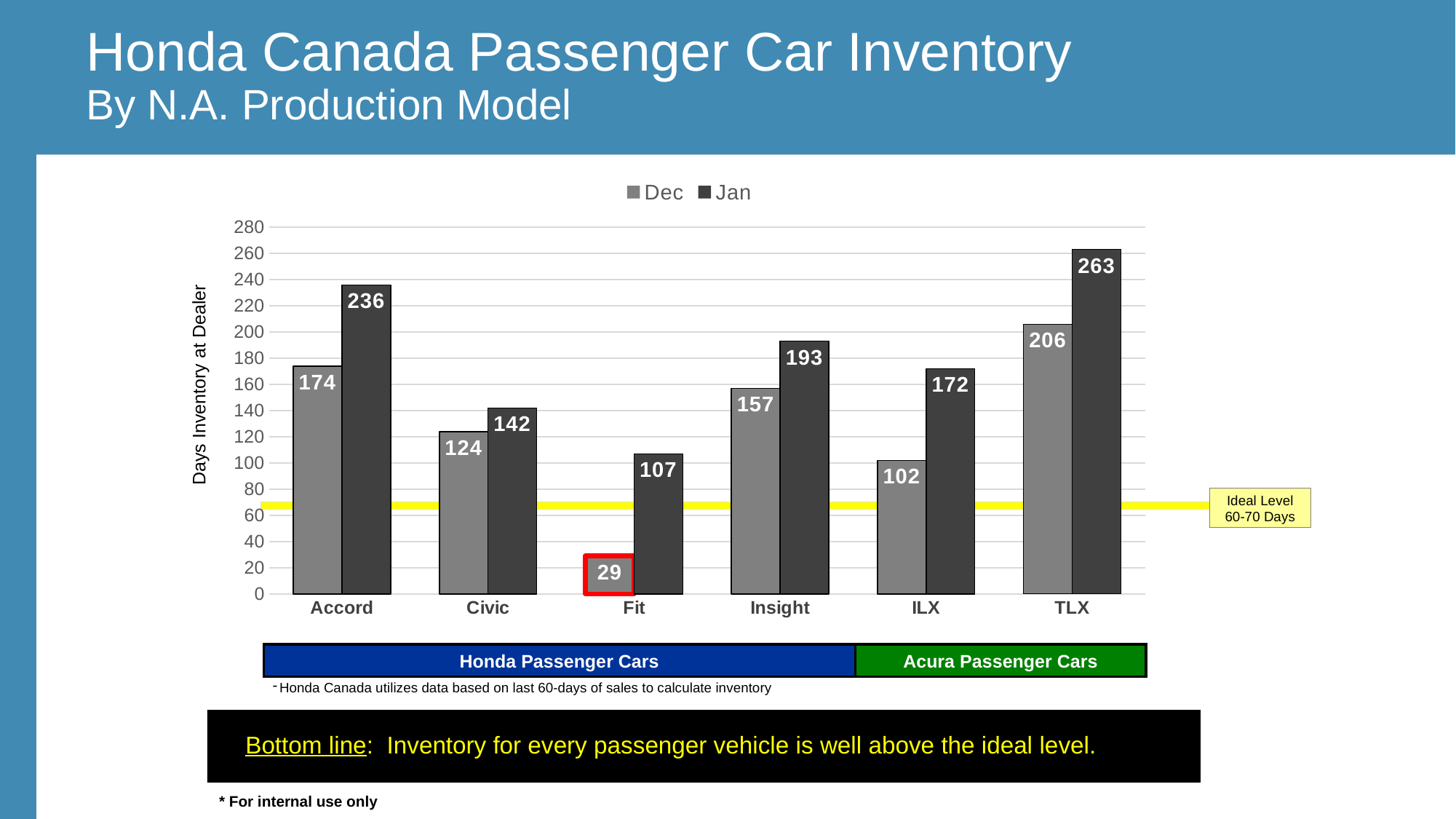
What is the Dec value for Fit? 29 What is the y-axis label of the chart? Days Inventory at Dealer Which model has the lowest Dec value? Fit What is the Dec value for ILX? 102 What is the Jan value for Accord? 236 Which is larger, the Jan value for Civic or the Jan value for ILX? ILX What kind of chart is shown? bar chart What is the difference between the Jan and Dec values for Insight? 36 Is the Dec value for TLX greater or less than 200? greater How many series does the legend list? 2 Which model has the highest Jan value? TLX How many models are shown on the x axis? 6